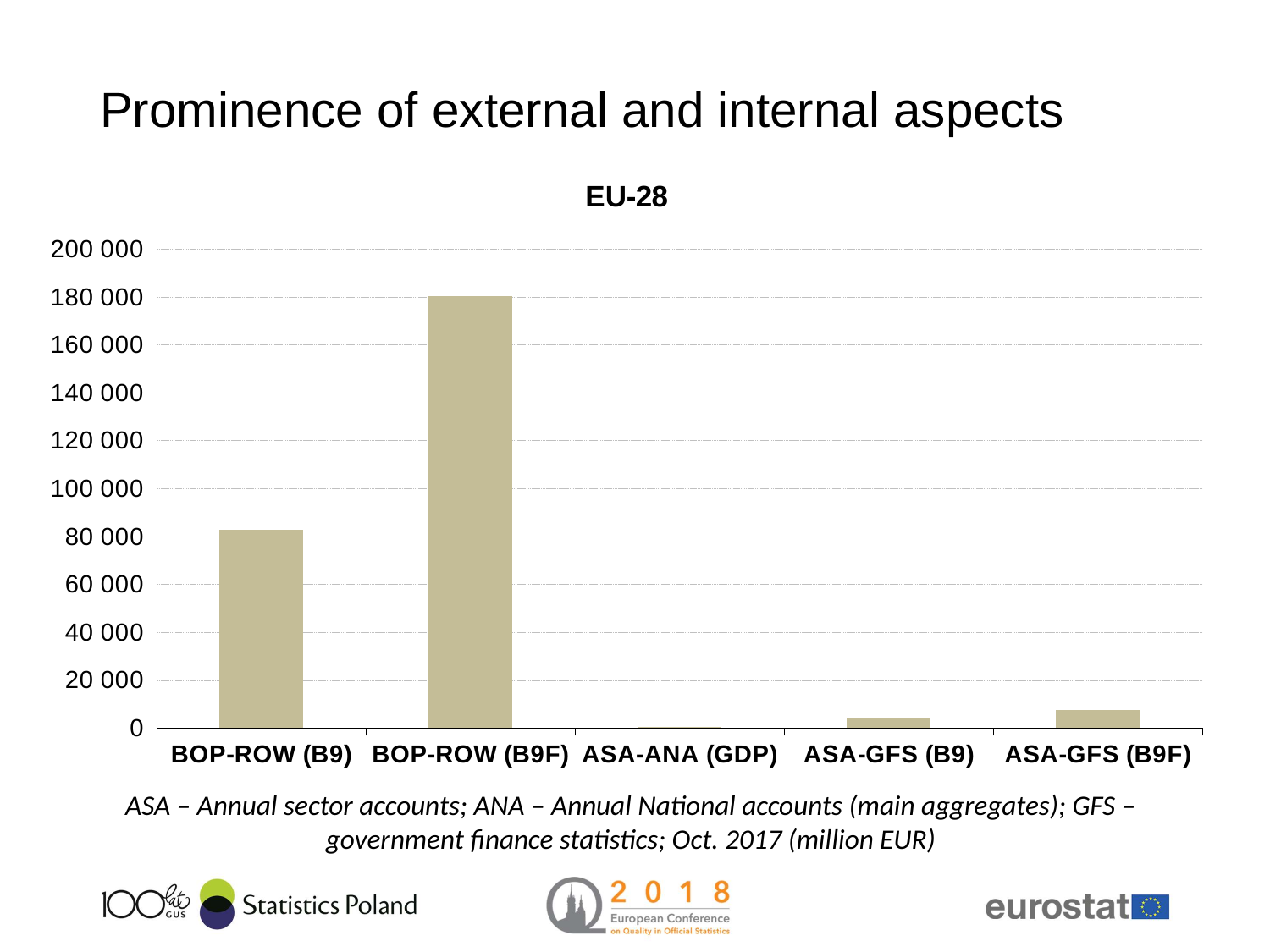
Which is larger, the value for ASA-GFS (B9) or the value for ASA-GFS (B9F)? ASA-GFS (B9F) What kind of chart is shown on the slide? bar chart Is the value for ASA-GFS (B9F) greater or less than 20 000? less Which category has the highest value in the chart? BOP-ROW (B9F) What is the title of the chart? EU-28 Is the value for BOP-ROW (B9F) greater or less than 160 000? greater Is the value for BOP-ROW (B9) greater or less than 60 000? greater Which category has the lowest value in the chart? ASA-ANA (GDP) What is the highest value shown on the vertical axis of the chart? 200 000 Which is larger, the value for BOP-ROW (B9) or the value for BOP-ROW (B9F)? BOP-ROW (B9F) How many categories are shown on the x axis of the chart? 5